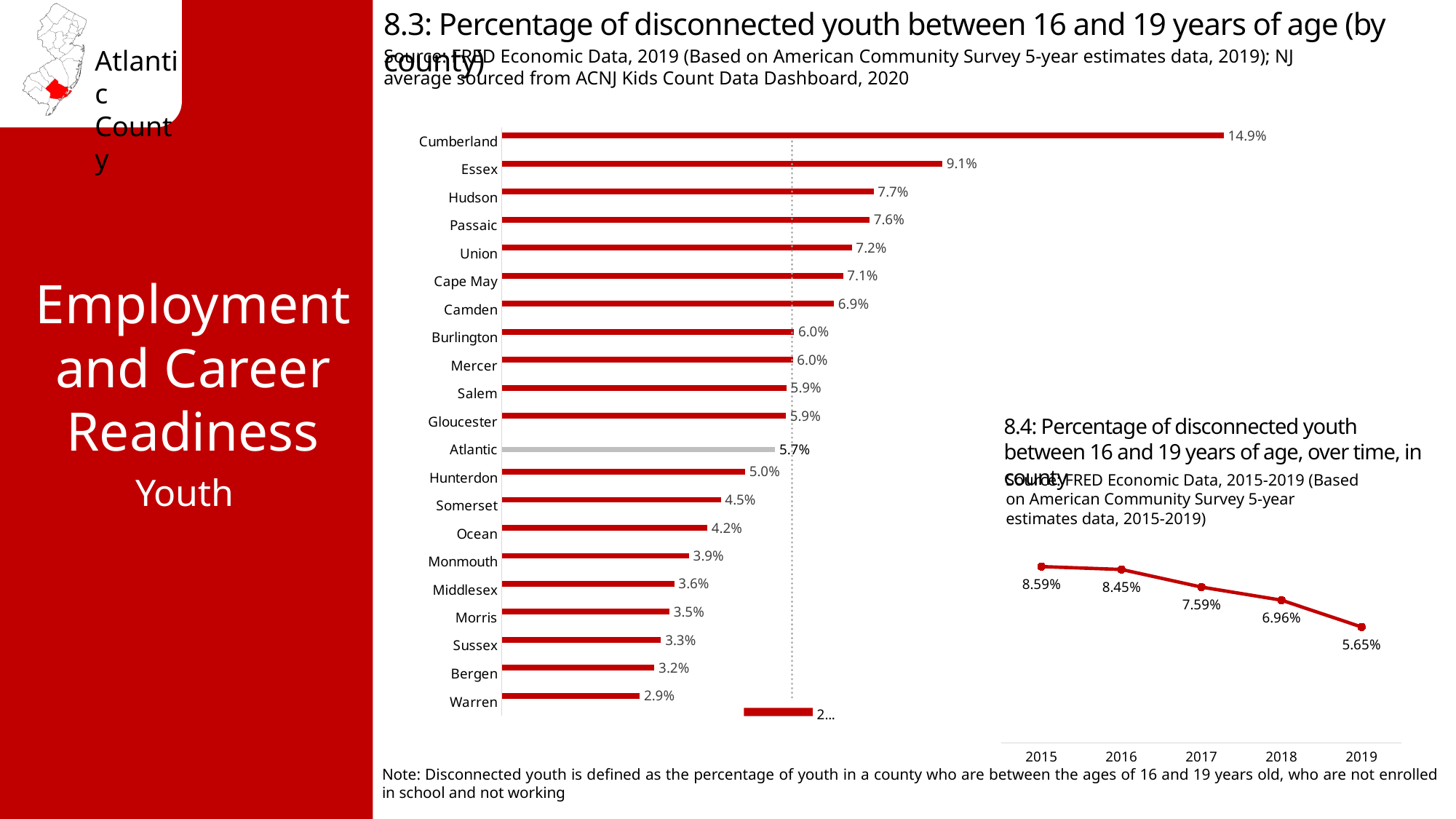
In chart 8.4, do the values rise or fall from 2015 to 2019? Fall In chart 8.3, what is the percentage of disconnected youth for Atlantic? 5.7% In chart 8.4, what is the difference between the values for 2015 and 2019? 2.94% In chart 8.4, what is the value for 2015? 8.59% How many counties are shown in chart 8.3? 21 In chart 8.3, which county has the lowest percentage of disconnected youth? Warren What kind of chart is chart 8.3? Bar chart In chart 8.3, which has a higher value, Ocean or Somerset? Somerset In chart 8.3, what is the difference between the values for Essex and Hudson? 1.4% In chart 8.4, what is the value for 2019? 5.65% In chart 8.3, what is the percentage of disconnected youth for Cumberland? 14.9% In chart 8.3, which county has the highest percentage of disconnected youth? Cumberland